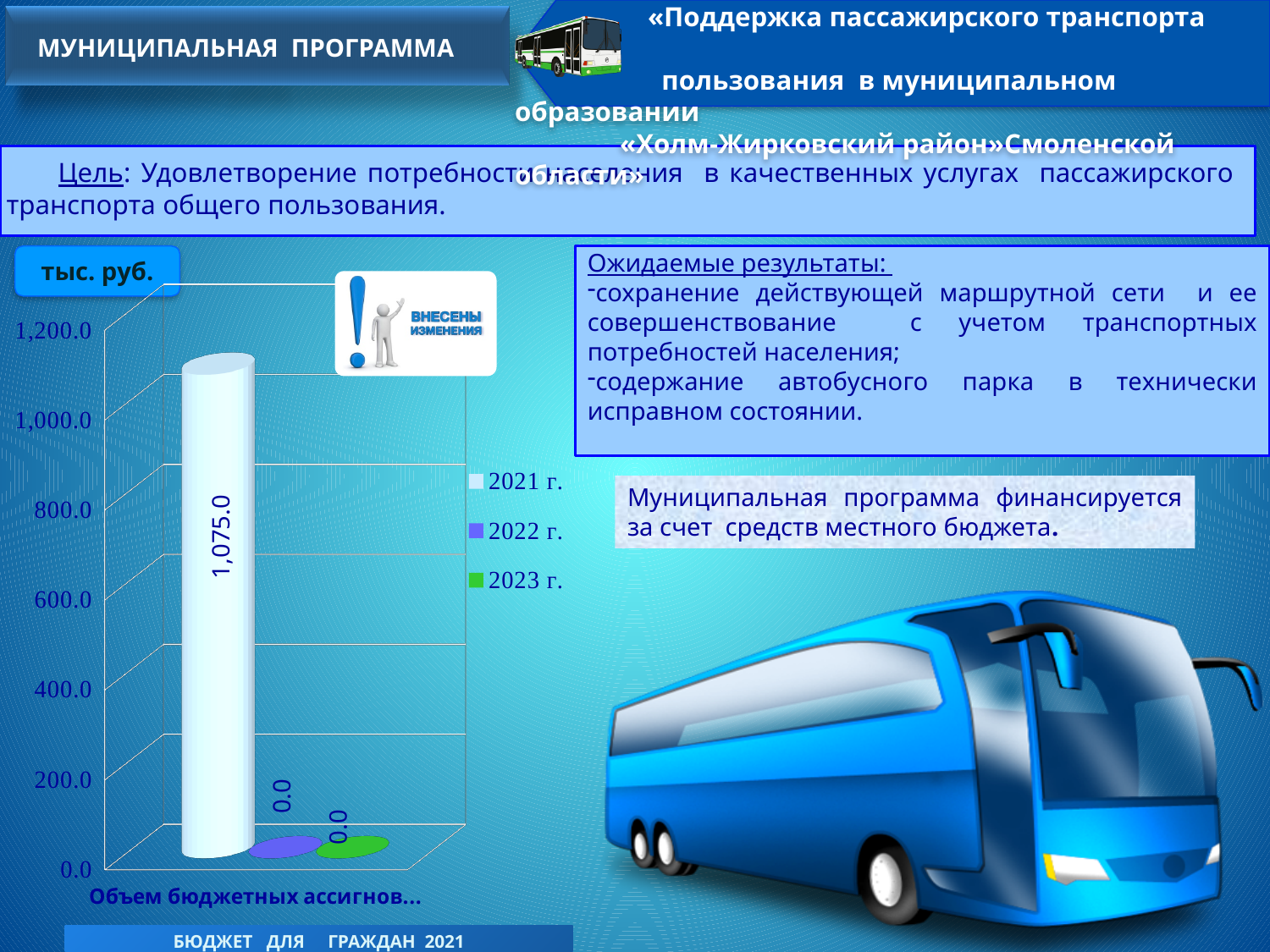
What unit is shown in the label above the chart's vertical axis? тыс. руб. What is the value for 2022 г. in the chart? 0.0 Is the value for 2021 г. greater or less than 1,000.0? greater How many series does the chart legend list? 3 What is the value for 2023 г. in the chart? 0.0 Which is larger, the value for 2021 г. or the value for 2023 г.? 2021 г. Is the value for 2021 г. greater or less than 1,200.0? less What is the difference between the values for 2021 г. and 2022 г.? 1,075.0 What is the highest tick value shown on the chart's vertical axis? 1,200.0 What is the value for 2021 г. in the chart? 1,075.0 Which year has the highest value in the chart? 2021 г. What kind of chart is shown on the slide? bar chart